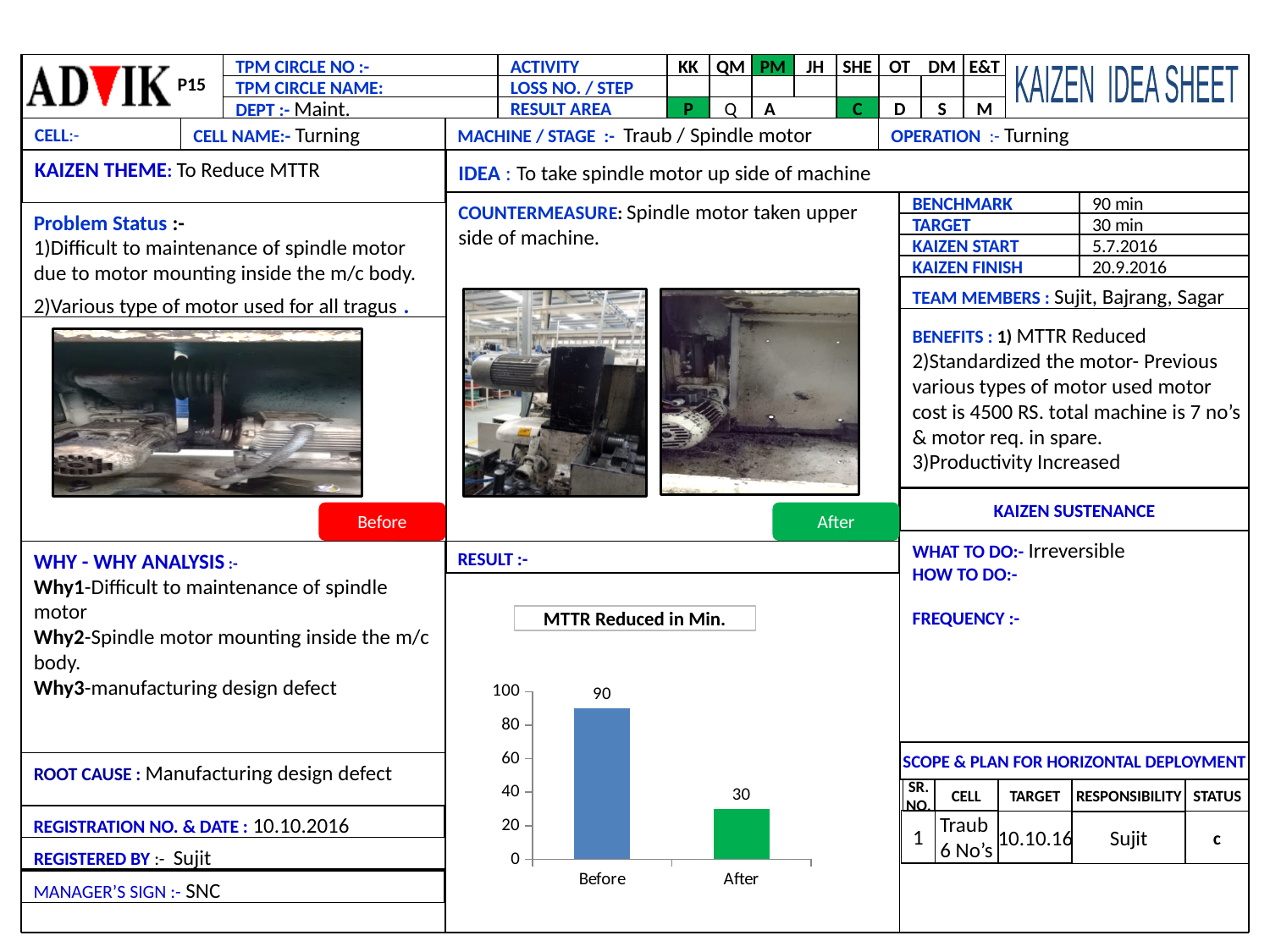
In the MTTR Reduced in Min. chart, which is larger, Before or After? Before What is the title of the chart in the RESULT section of the slide? MTTR Reduced in Min. What is the difference between the Before and After values in the MTTR Reduced in Min. chart? 60 What is the value for Before in the MTTR Reduced in Min. chart? 90 What kind of chart is the MTTR Reduced in Min. chart? bar chart Which category has the lowest value in the MTTR Reduced in Min. chart? After Which category has the highest value in the MTTR Reduced in Min. chart? Before Is the value for After in the MTTR Reduced in Min. chart greater or less than 40? less Is the value for Before in the MTTR Reduced in Min. chart greater or less than 80? greater How many categories are shown in the MTTR Reduced in Min. chart? 2 What is the value for After in the MTTR Reduced in Min. chart? 30 Do the values rise or fall from Before to After in the MTTR Reduced in Min. chart? fall